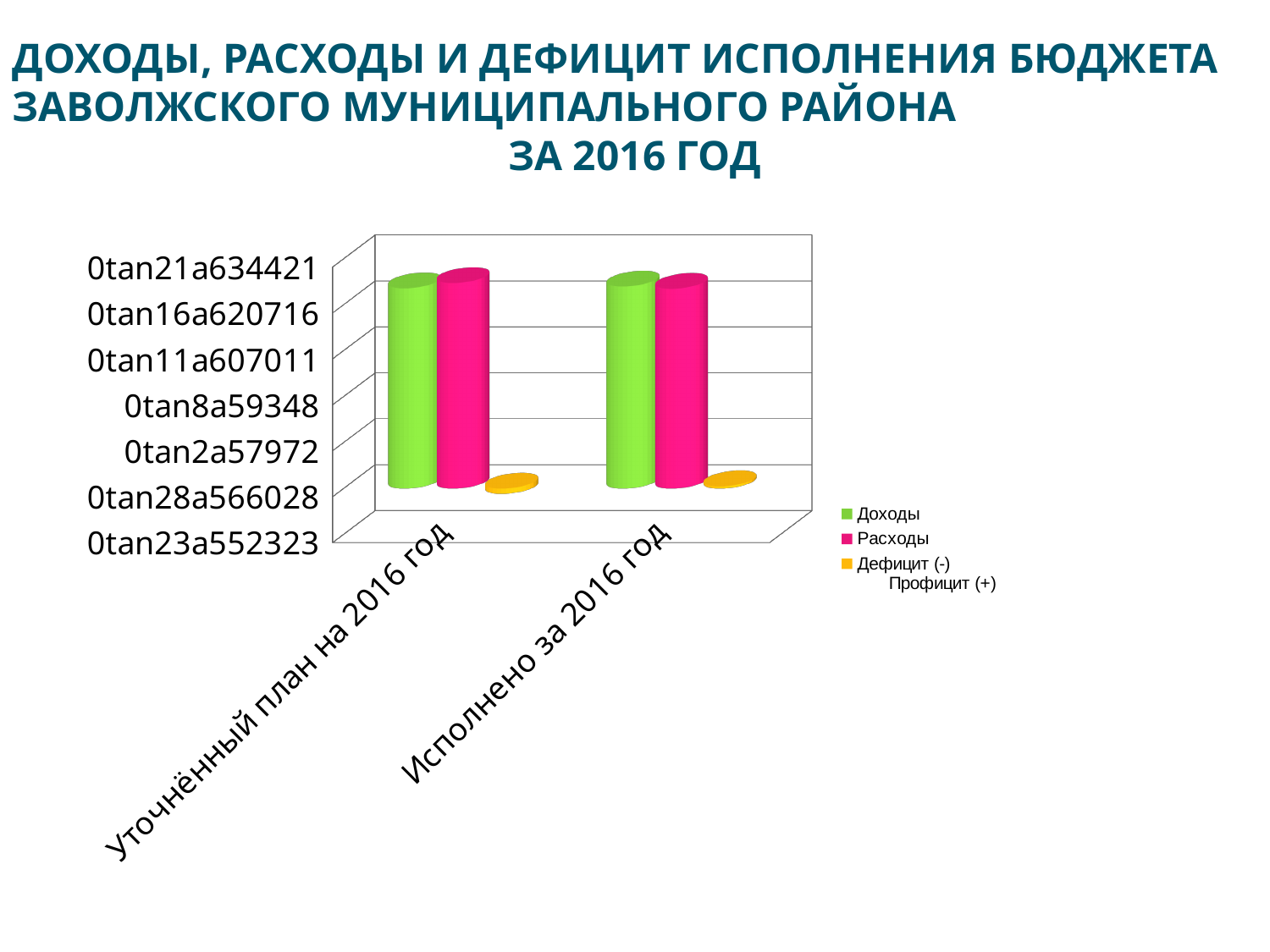
How many categories are shown on the x axis of the chart? 2 Which series has the lowest value in the category 'Уточнённый план на 2016 год'? Дефицит (-) Профицит (+) Which series is shown in green in the chart? Доходы What kind of chart is shown on the slide? bar chart How many series does the chart's legend list? 3 Which series has the lowest value in the category 'Исполнено за 2016 год'? Дефицит (-) Профицит (+) What are the two categories on the x axis of the chart? Уточнённый план на 2016 год; Исполнено за 2016 год In the category 'Уточнённый план на 2016 год', which is larger: Доходы or Дефицит (-) Профицит (+)? Доходы In the category 'Исполнено за 2016 год', which is larger: Расходы or Дефицит (-) Профицит (+)? Расходы